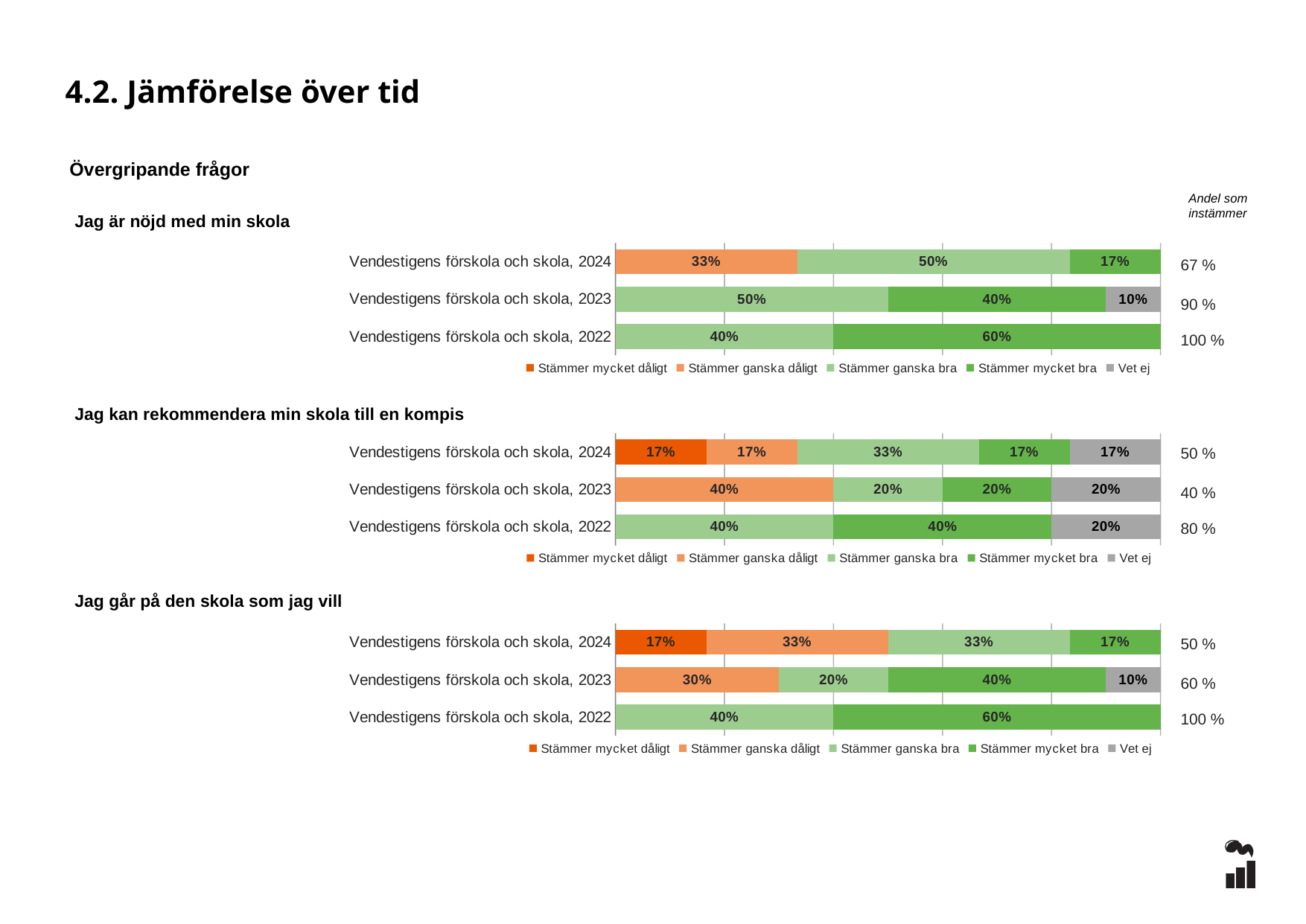
In the chart 'Jag är nöjd med min skola', is the 'Stämmer ganska bra' value for 2023 larger or smaller than for 2022? larger In the chart 'Jag kan rekommendera min skola till en kompis', what is the 'Stämmer ganska dåligt' value for Vendestigens förskola och skola, 2023? 40% What kind of chart is used for 'Jag är nöjd med min skola'? Stacked bar chart In the chart 'Jag är nöjd med min skola', what is the 'Stämmer ganska bra' value for Vendestigens förskola och skola, 2024? 50% How many bars are shown in the chart 'Jag kan rekommendera min skola till en kompis'? 3 In the chart 'Jag kan rekommendera min skola till en kompis', what is the 'Vet ej' value for Vendestigens förskola och skola, 2022? 20% In the chart 'Jag är nöjd med min skola', what is the 'Stämmer mycket bra' value for Vendestigens förskola och skola, 2022? 60% In the chart 'Jag är nöjd med min skola', what is the 'Andel som instämmer' shown for Vendestigens förskola och skola, 2023? 90 % In the chart 'Jag kan rekommendera min skola till en kompis', what is the difference between the 'Stämmer mycket bra' values for 2022 and 2023? 20% In the chart 'Jag går på den skola som jag vill', which year has the highest 'Stämmer mycket bra' value? 2022 How many series does the legend list in the chart 'Jag går på den skola som jag vill'? 5 In the chart 'Jag går på den skola som jag vill', what is the 'Stämmer mycket dåligt' value for Vendestigens förskola och skola, 2024? 17%